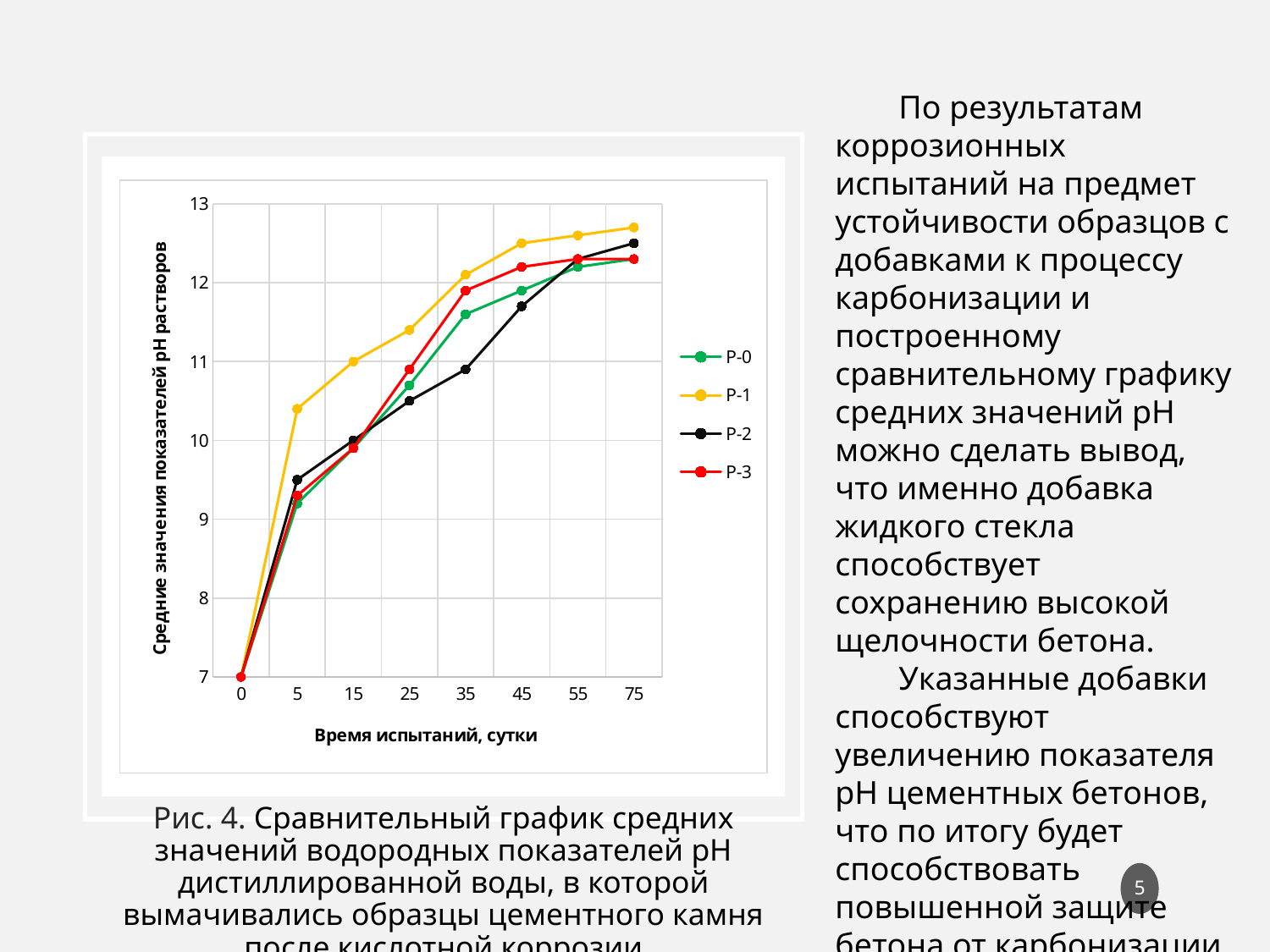
How many time points are plotted along the x axis? 8 Which series has the highest value at 75 days? Р-1 What kind of chart is shown on the slide? line chart Is the value for Р-1 at 75 days greater or less than 12? greater What is the value of Р-1 at time 0? 7 How many series does the legend list? 4 Which series has the highest value at 5 days? Р-1 Is the value for Р-2 at 45 days greater or less than 11? greater Is the value for Р-0 at 25 days greater or less than 11? less What is the value of Р-1 at 15 days? 11 Do the values of Р-3 rise or fall as time increases along the x axis? rise What is the title of the x axis? Время испытаний, сутки